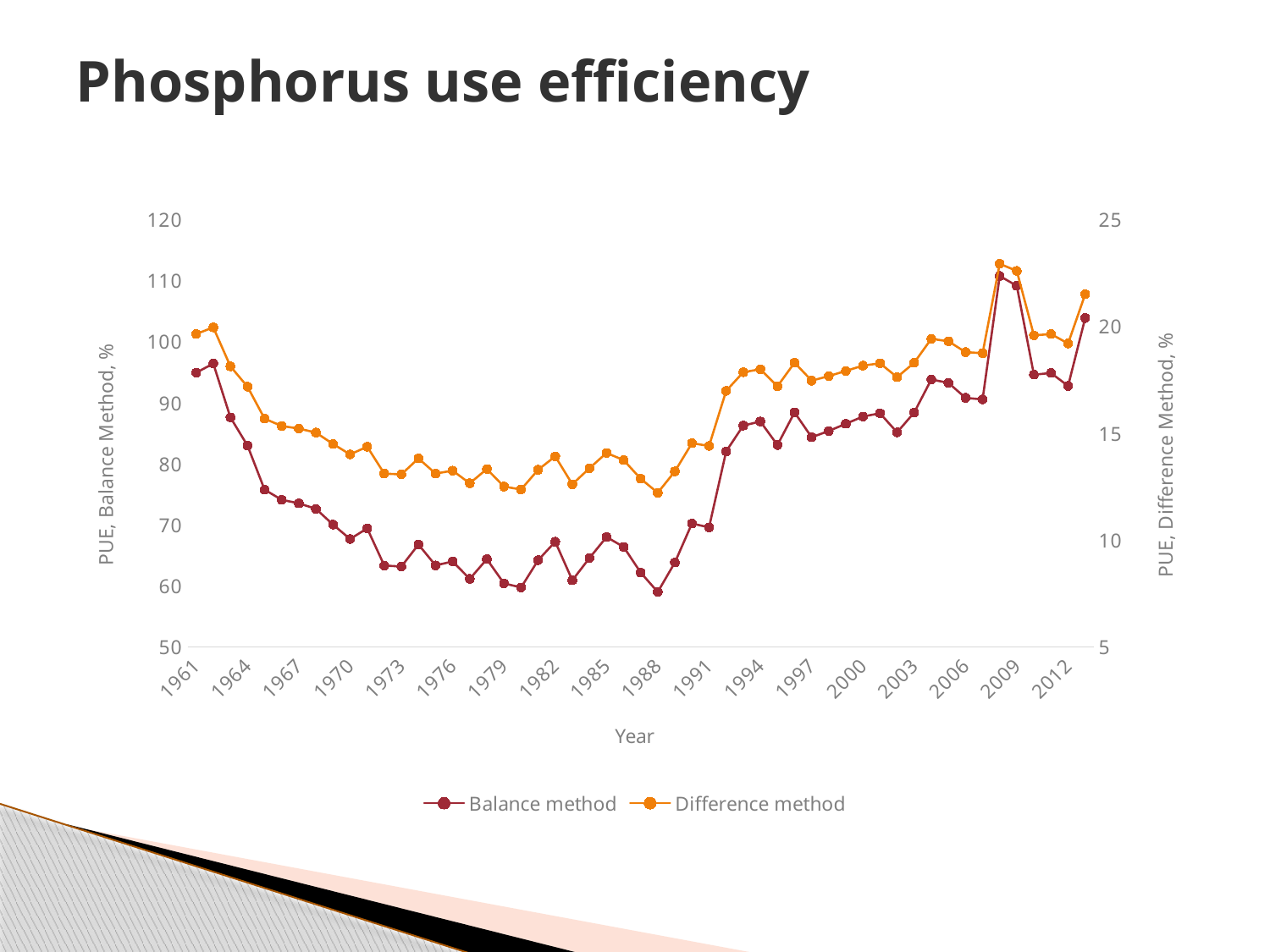
What is the title of the left vertical axis? PUE, Balance Method, % Which is larger for the Balance method: the value in 1961 or the value in 1988? 1961 Does the Balance method series rise or fall between 1961 and 1970? Fall What are the two series named in the legend? Balance method and Difference method Is the Difference method value for 2009 greater or less than 20 on the right axis? greater Is the Balance method value for 1961 greater or less than 90? greater In which year does the Balance method series reach its highest value? 2008 Is the Difference method value for 1961 greater or less than 15 on the right axis? greater What kind of chart is shown on the slide? Line chart Does the Difference method series rise or fall between 1988 and 1994? Rise How many series does the legend list? 2